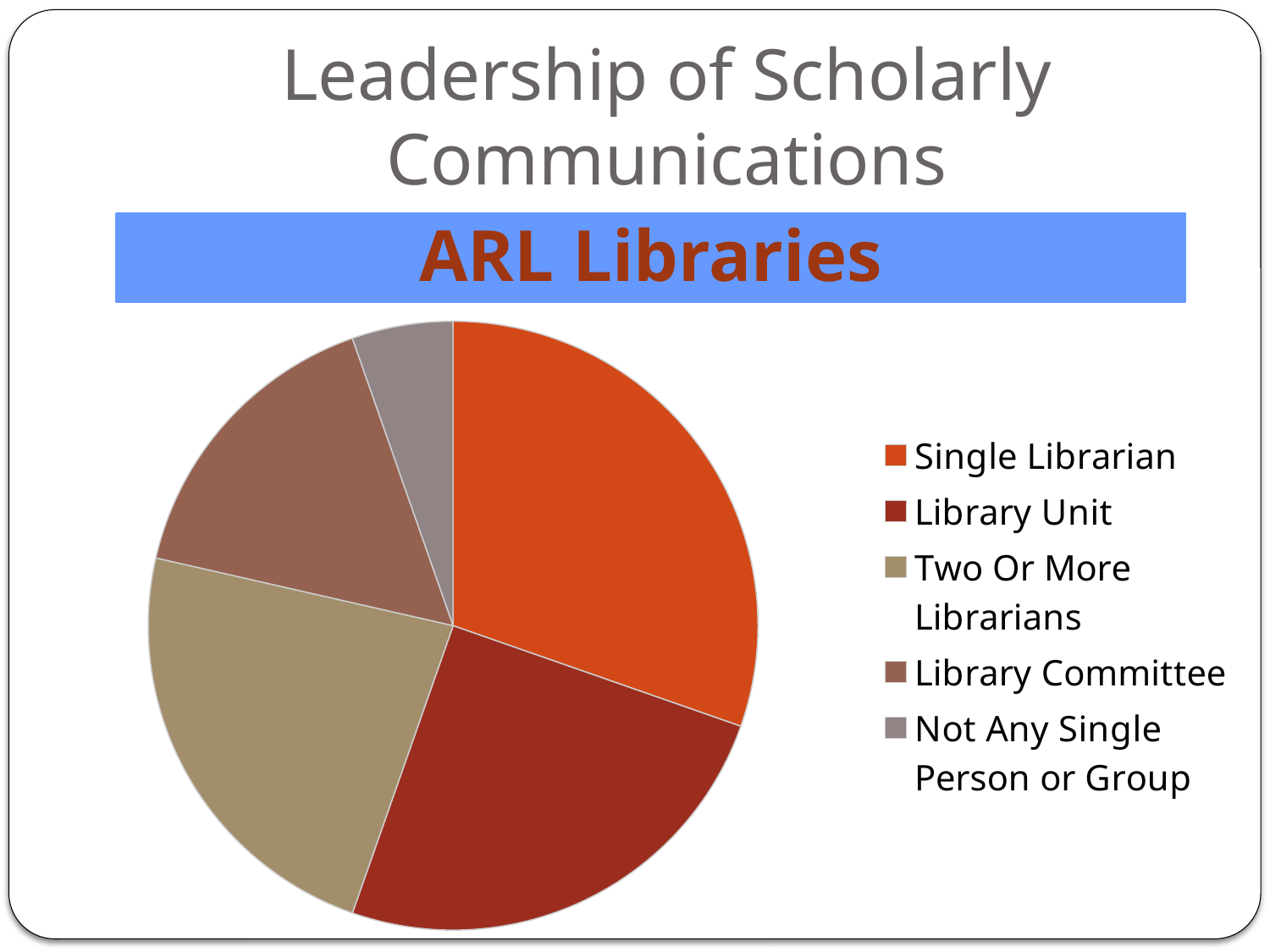
Which slice is larger: Library Unit or Not Any Single Person or Group? Library Unit What kind of chart is shown on the slide? pie chart How many entries does the legend of the pie chart list? 5 Which slice is larger: Two Or More Librarians or Library Committee? Two Or More Librarians How many slices does the pie chart have? 5 Which category has the smallest slice of the pie chart? Not Any Single Person or Group Which category has the largest slice of the pie chart? Single Librarian Which slice is larger: Library Committee or Not Any Single Person or Group? Library Committee Which group of libraries does the pie chart describe, according to the banner above it? ARL Libraries What is the title of the slide containing the pie chart? Leadership of Scholarly Communications